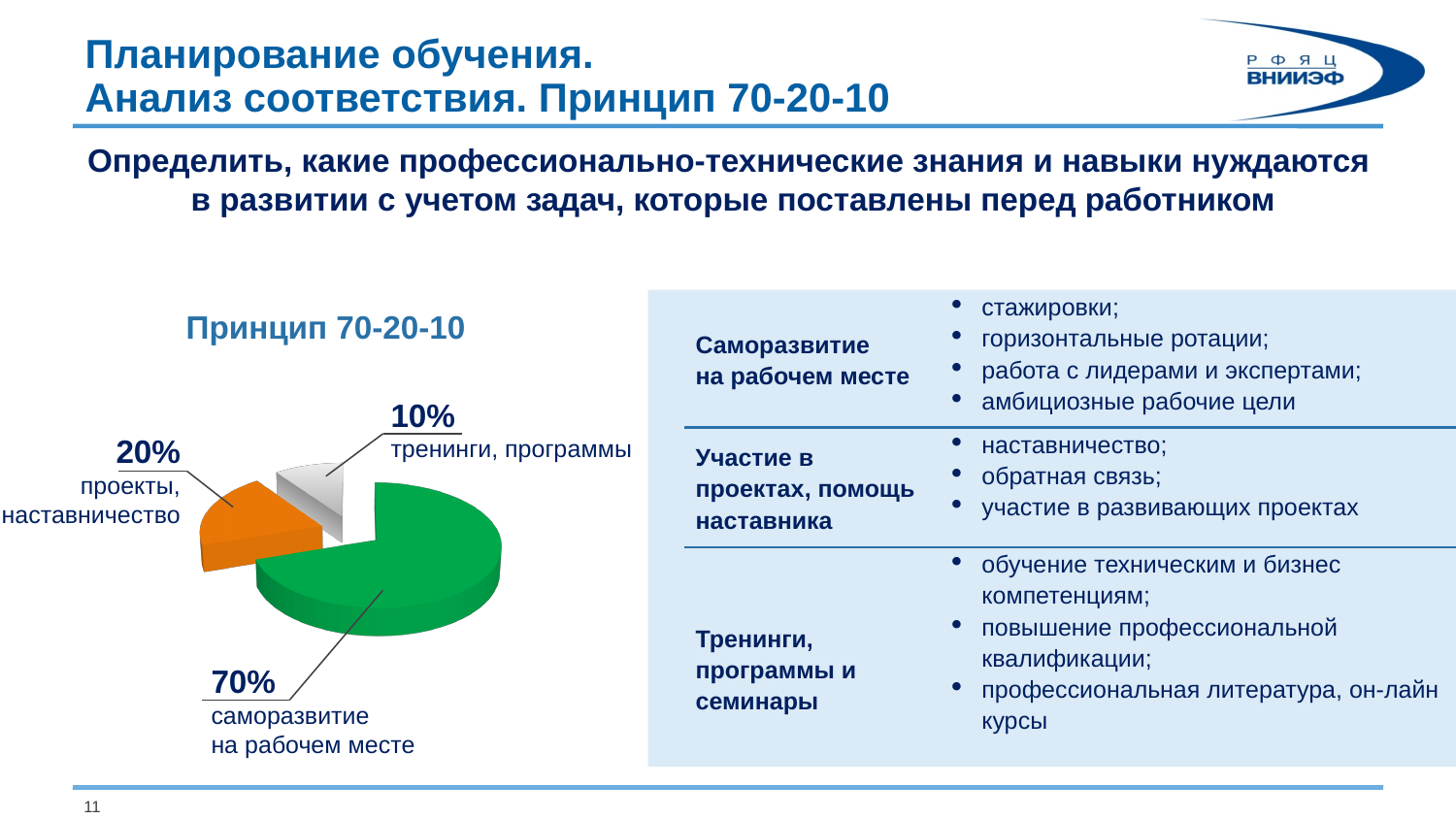
What is the difference between the shares for "саморазвитие на рабочем месте" and "проекты, наставничество"? 50% What kind of chart is shown on the slide? Pie chart What is the title of the chart? Принцип 70-20-10 What colour is the slice for "саморазвитие на рабочем месте"? Green Which slice of the pie chart is the largest? саморазвитие на рабочем месте What share of the pie is labelled "тренинги, программы"? 10% What is the combined share of "проекты, наставничество" and "тренинги, программы"? 30% Which slice of the pie chart is the smallest? тренинги, программы How many slices does the pie chart have? 3 Which is larger: the share for "проекты, наставничество" or the share for "тренинги, программы"? проекты, наставничество What share of the pie is labelled "саморазвитие на рабочем месте"? 70% What share of the pie is labelled "проекты, наставничество"? 20%